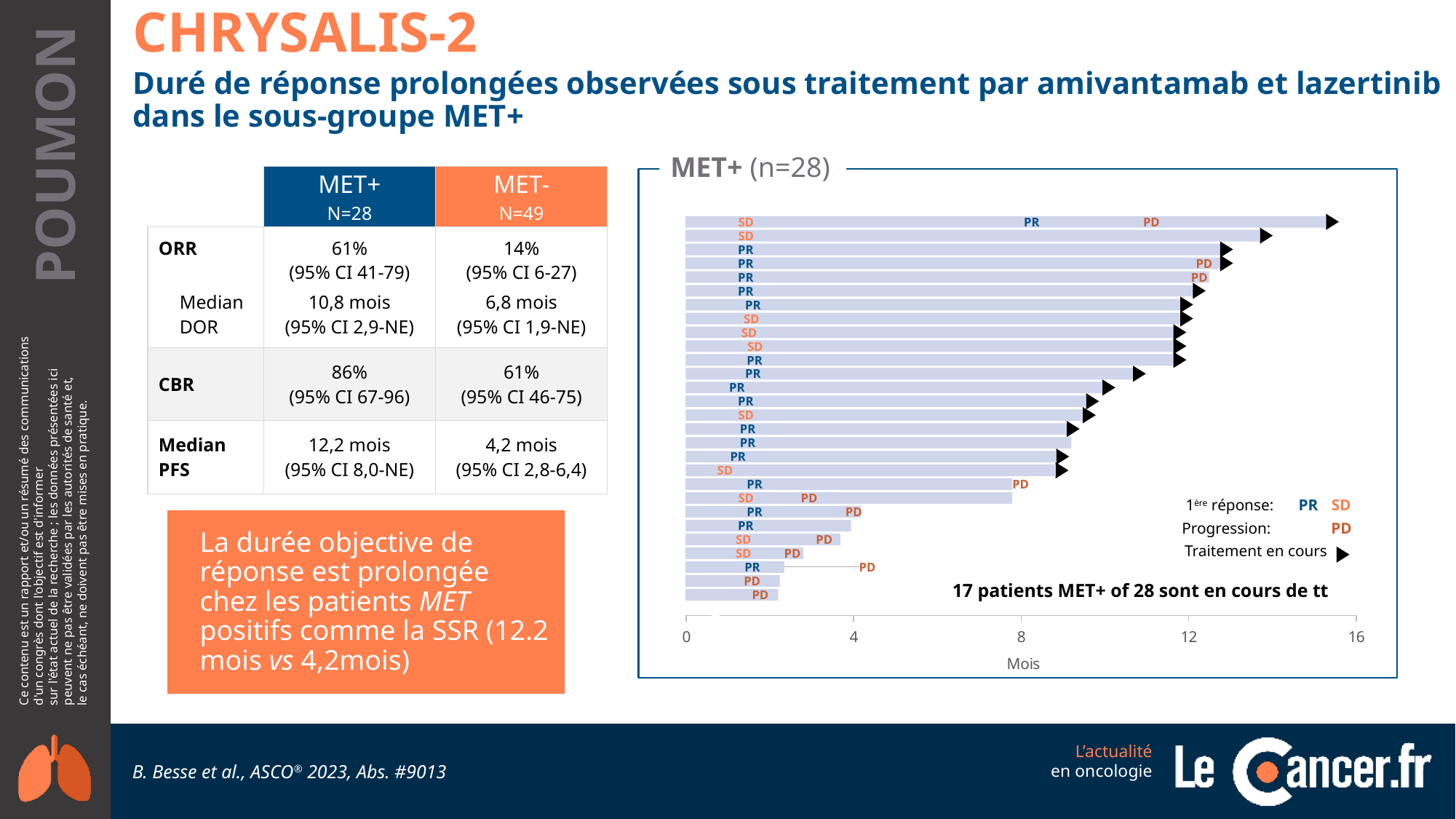
According to the text in the MET+ chart, how many of the 28 MET+ patients are still on treatment? 17 What is the unit of the x axis of the MET+ chart? Mois How many patients (bars) are plotted in the MET+ chart? 28 In the MET+ chart legend, which label marks progression? PD What is the highest tick value shown on the x axis of the MET+ chart? 16 Is the duration of the shortest bar in the MET+ chart greater or less than 4 months? less In the MET+ chart, do the bar lengths increase or decrease from the top bar to the bottom bar? decrease What kind of chart is shown in the MET+ (n=28) panel? bar chart Is the duration of the longest bar in the MET+ chart greater or less than 12 months? greater